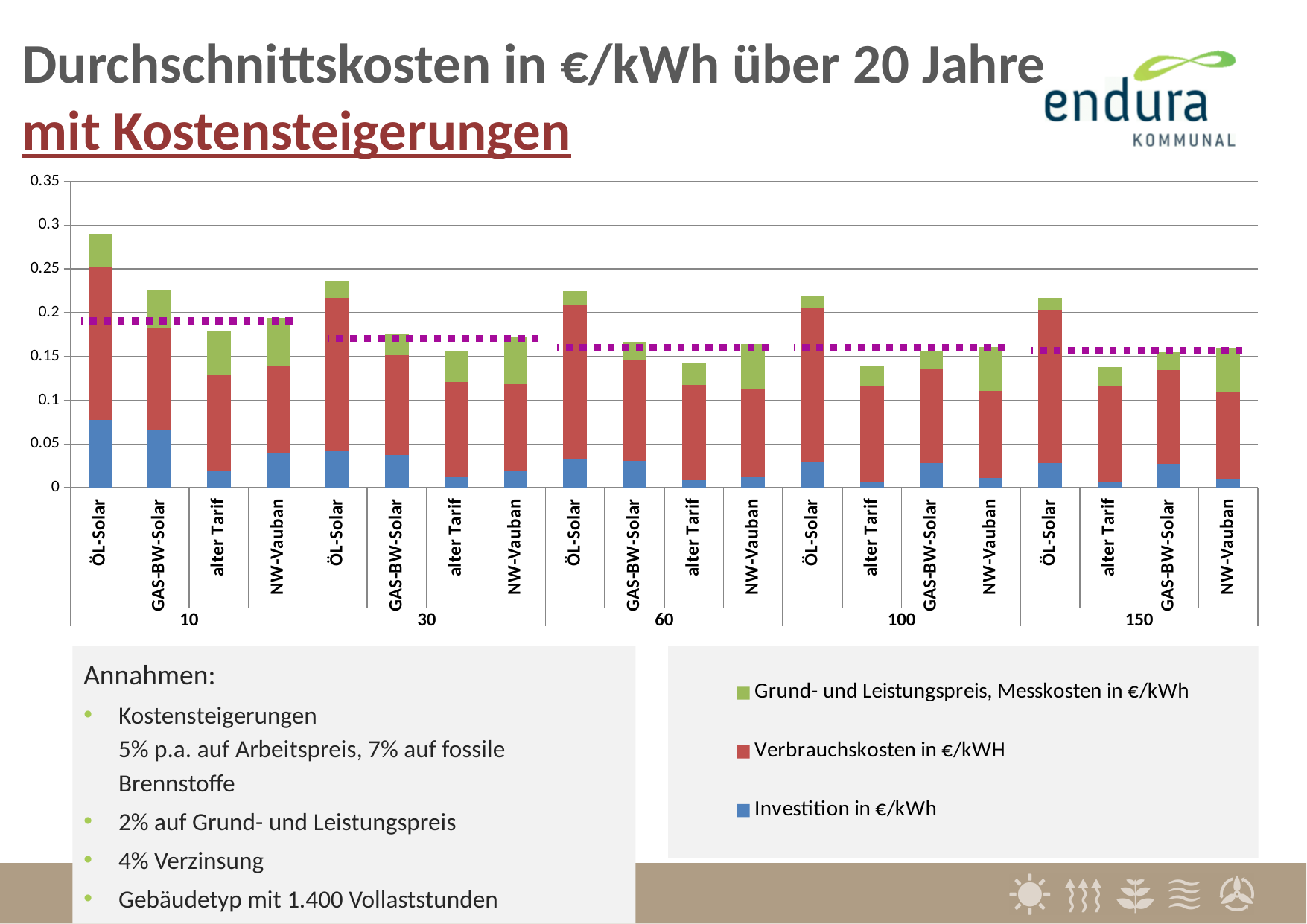
What kind of chart is shown on the slide? stacked bar chart How many groups are shown along the x axis of the chart? 5 Is the total for GAS-BW-Solar in group 10 greater or less than 0.2? greater Does the total for ÖL-Solar rise or fall from group 10 to group 150? fall Which series is shown in blue according to the legend? Investition in €/kWh How many bars are plotted in the chart in total? 20 How many series does the legend list? 3 Which is larger in group 60: the total for ÖL-Solar or the total for alter Tarif? ÖL-Solar Is the total for ÖL-Solar in group 10 greater or less than 0.25? greater What is the highest value shown on the y axis? 0.35 Which bar has the highest total in the chart? ÖL-Solar in group 10 Is the total for alter Tarif in group 150 greater or less than 0.15? less